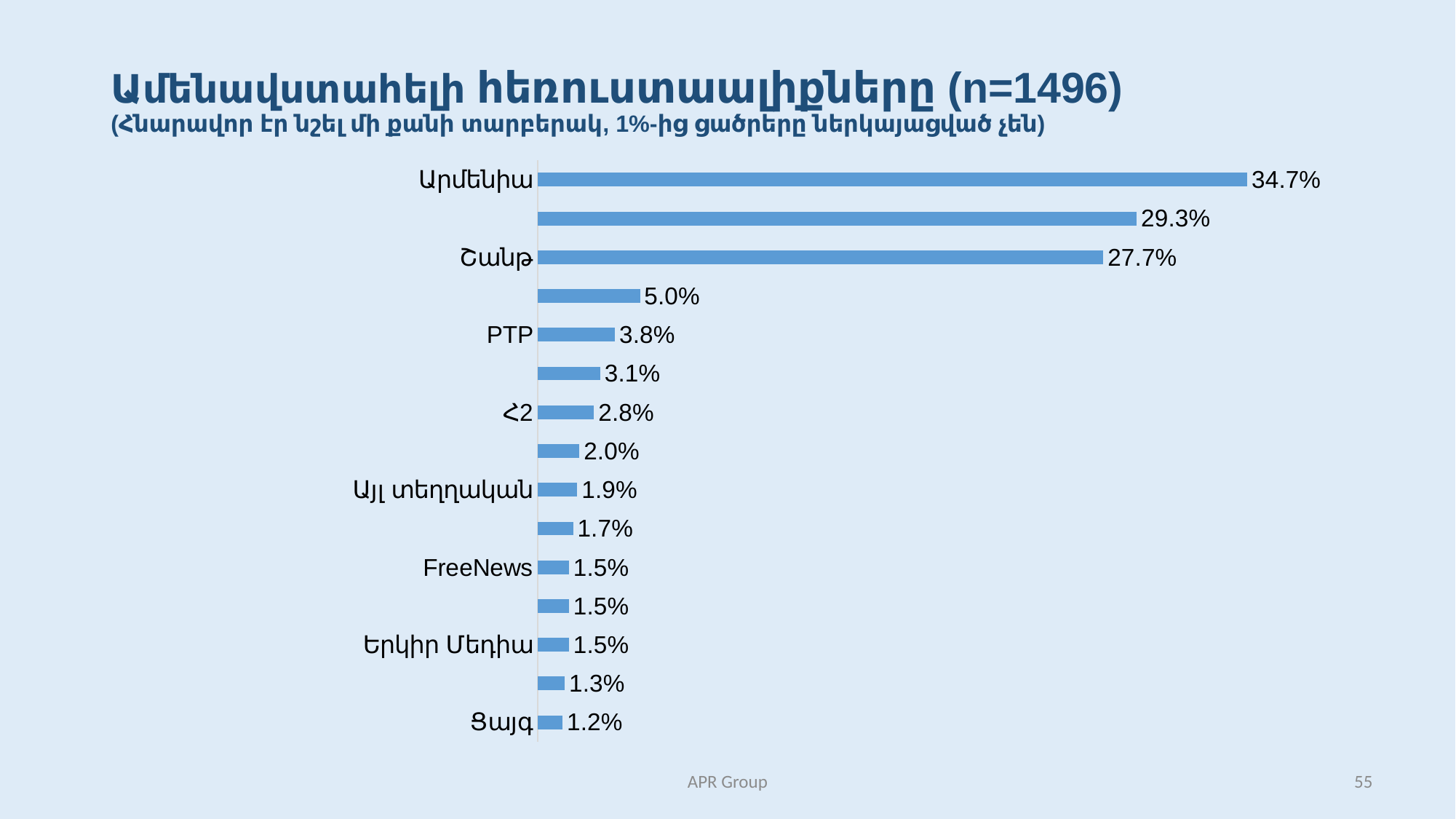
What is the value for Այլ տեղական? 1.9% Which is larger, the value for PTP or the value for Հ2? PTP What is the difference between the values for Արմենիա and Շանթ? 7.0 percentage points What is the value for Շանթ? 27.7% What is the value for Արմենիա? 34.7% What is the value for Երկիր Մեդիա? 1.5% How many bars are plotted in the chart? 15 What is the value for PTP? 3.8% What kind of chart is shown on the slide? Bar chart What is the value for Հ2? 2.8% Which category has the highest value? Արմենիա Which category has the lowest value? Ցայգ